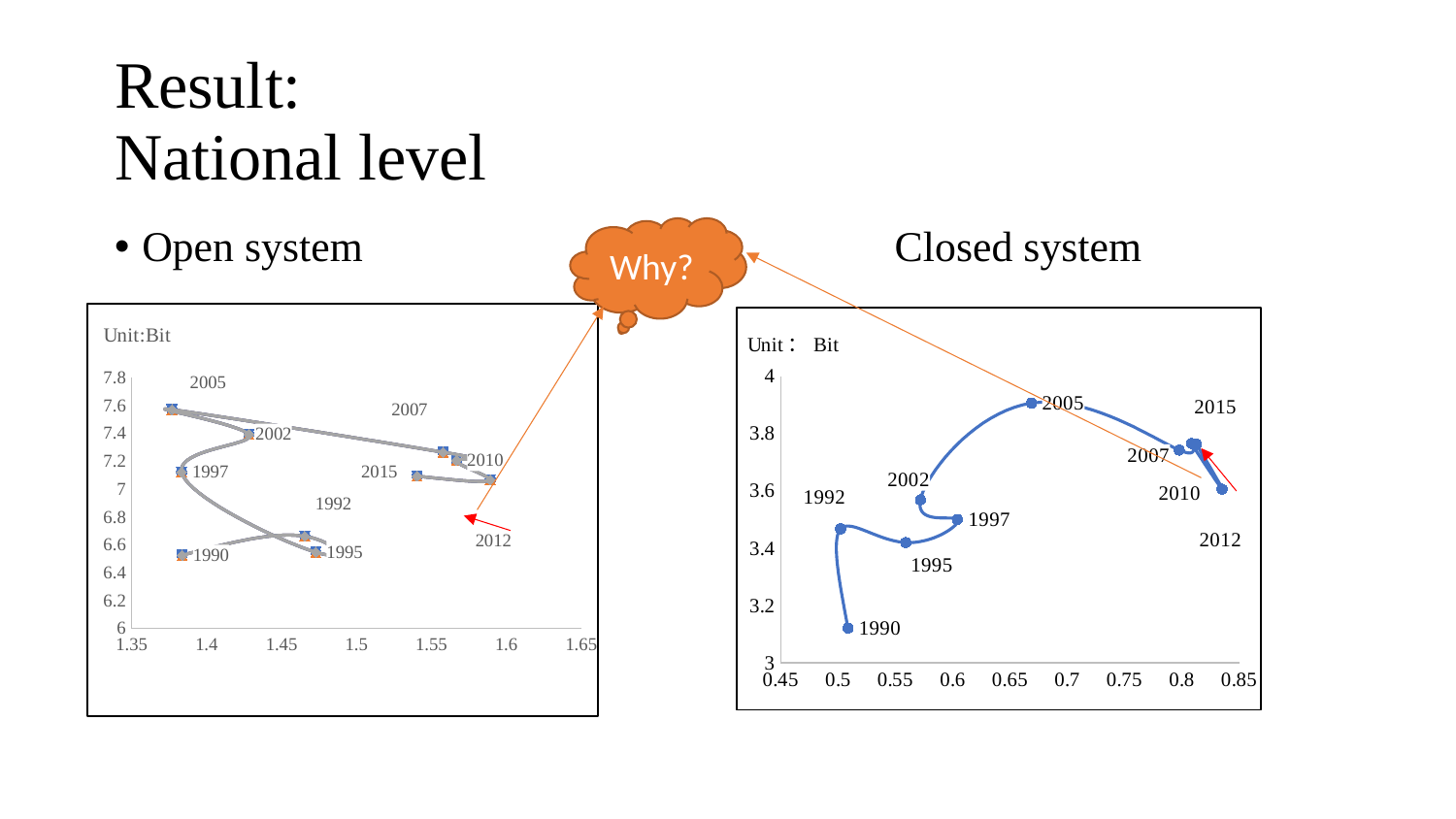
On the Open system chart, which year has the highest vertical-axis value? 2005 What kind of chart is the Open system chart on the left? scatter chart with smoothed lines What unit is stated on the Closed system chart? Bit On the Closed system chart, is the vertical-axis value for 1990 greater or less than 3.2? less How many labelled year points are plotted on the Open system chart? 10 On the Open system chart, which year has a higher vertical-axis value, 1997 or 1995? 1997 On the Closed system chart, which year has the highest vertical-axis value? 2005 On the Open system chart, is the horizontal-axis value for 2012 greater or less than 1.55? greater On the Closed system chart, is the vertical-axis value for 2005 greater or less than 3.8? greater How many labelled year points are plotted on the Closed system chart? 10 On the Closed system chart, which year lies furthest to the right on the horizontal axis? 2012 On the Closed system chart, which year has the lowest vertical-axis value? 1990